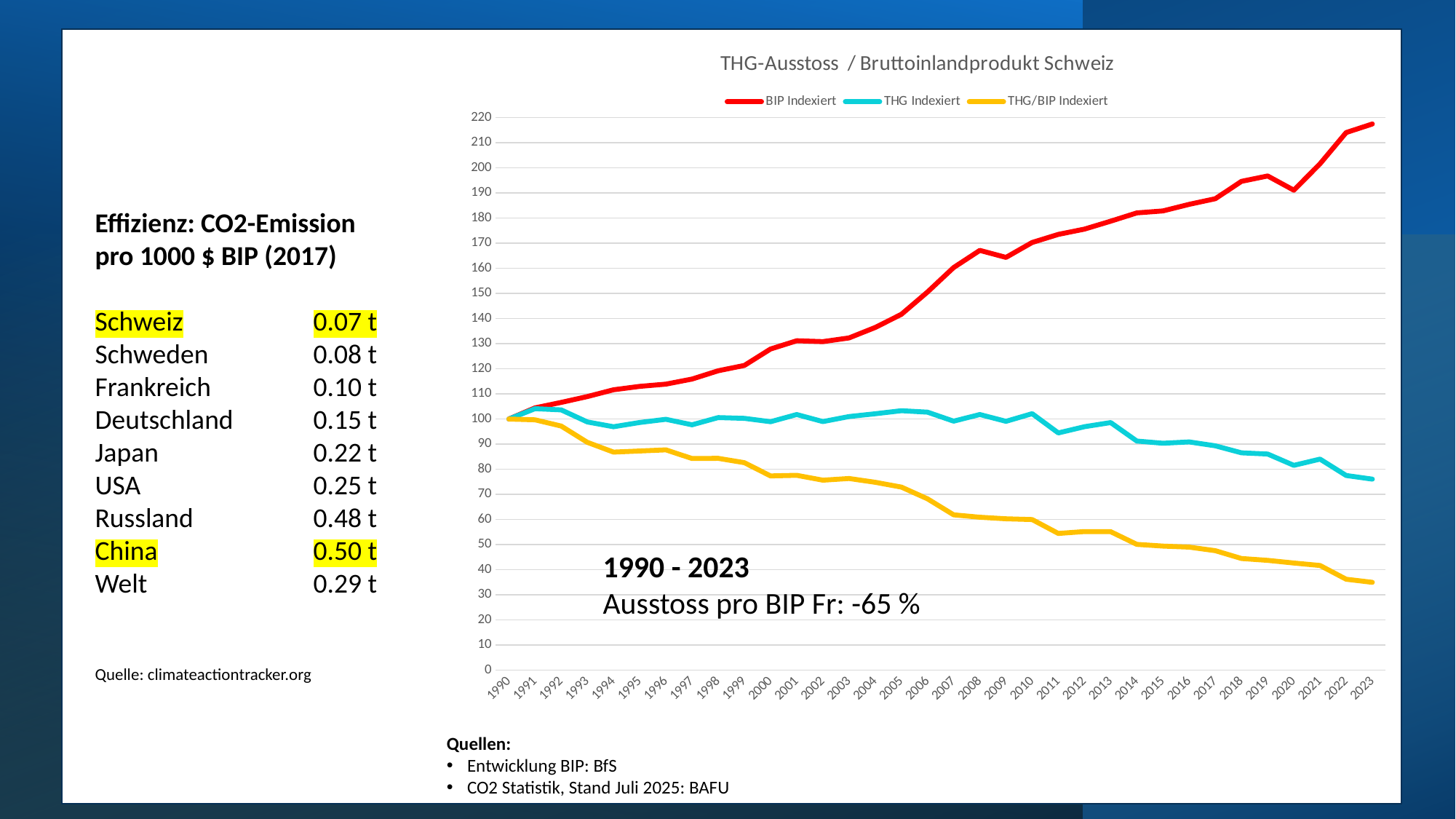
How many years are plotted along the x axis of the chart? 34 What kind of chart is shown on the slide? line chart Which series in the chart is drawn in red? BIP Indexiert Is the value of THG/BIP Indexiert in 2023 greater or less than 40? less Which series has the lowest value in 2023? THG/BIP Indexiert Does the THG/BIP Indexiert series rise or fall from 1990 to 2023? fall Does the BIP Indexiert series rise or fall from 1990 to 2023? rise In 2023, which is larger: THG Indexiert or THG/BIP Indexiert? THG Indexiert Which series has the highest value in 2023? BIP Indexiert What is the title of the chart? THG-Ausstoss / Bruttoinlandprodukt Schweiz How many series does the legend of the chart list? 3 Is the value of BIP Indexiert in 2023 greater or less than 210? greater